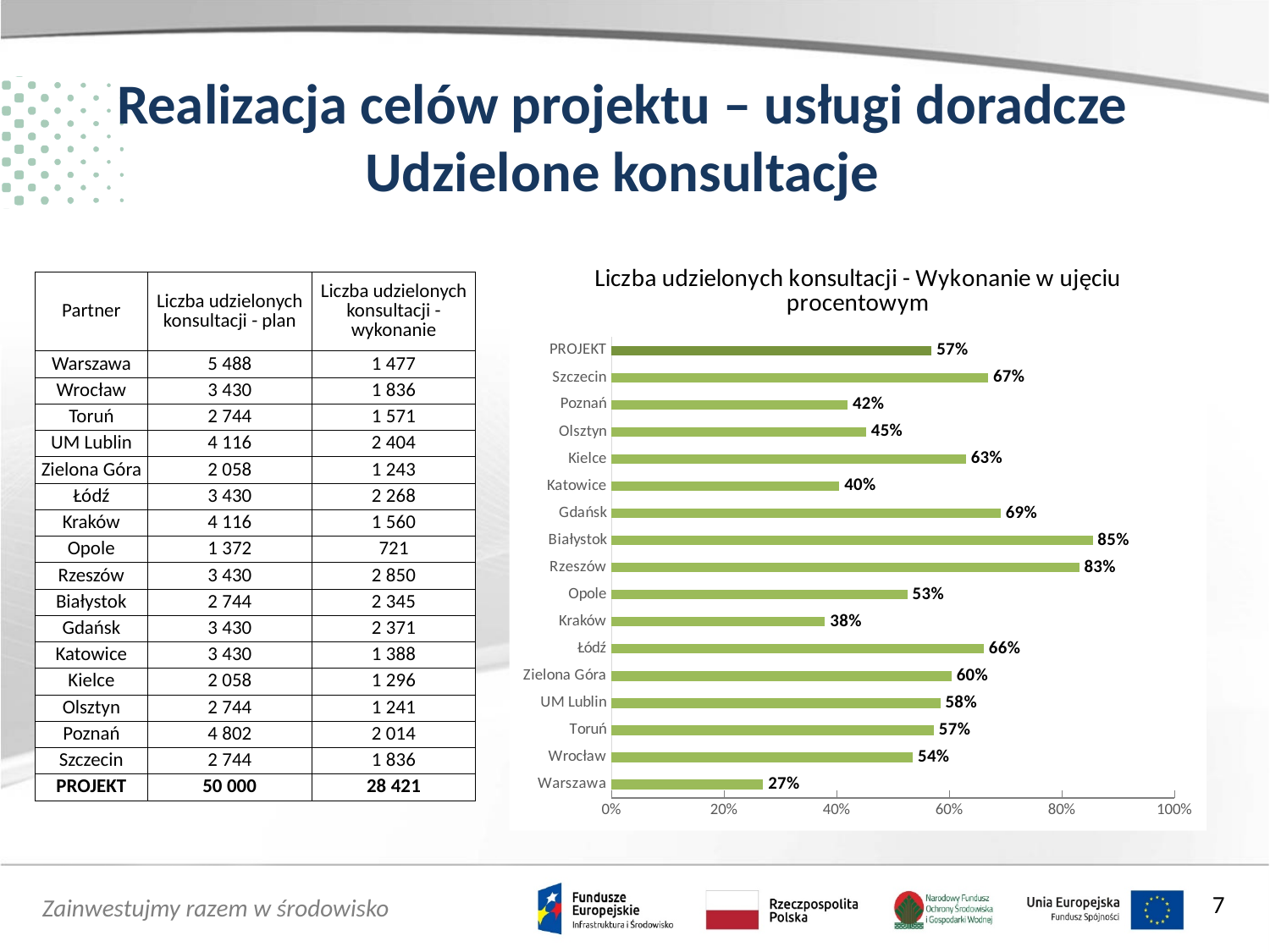
How many bars are shown in the chart? 17 What is the value for PROJEKT in the chart? 57% What is the difference between the values for Rzeszów and Opole? 30% What type of chart is shown on the slide? Bar chart What is the value for Warszawa in the chart? 27% Which has a larger value, Szczecin or Kielce? Szczecin What is the value for Kraków in the chart? 38% What is the value for Białystok in the chart? 85% Which category has the lowest value in the chart? Warszawa Is the value for Gdańsk greater or less than 60%? greater What is the title of the chart? Liczba udzielonych konsultacji - Wykonanie w ujęciu procentowym Which category has the highest value in the chart? Białystok